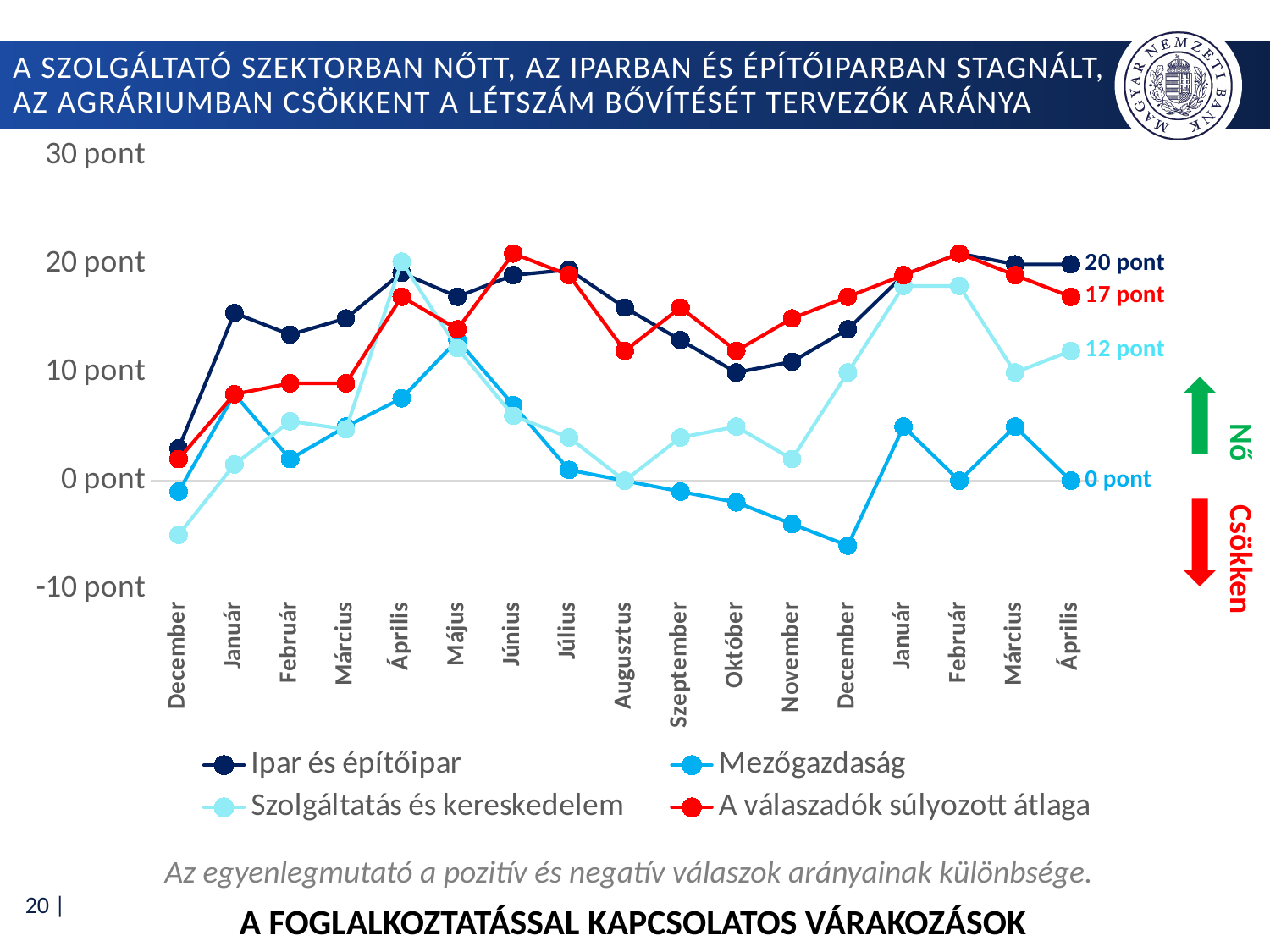
What is the value for Mezőgazdaság at the final Április? 0 pont What is the value for Szolgáltatás és kereskedelem at the final Április? 12 pont What kind of chart is shown on the slide? line chart What is the value for A válaszadók súlyozott átlaga at the final Április? 17 pont Is the value for Mezőgazdaság at the second December greater or less than 0 pont? less How many months are shown along the x axis? 17 What is the title printed below the chart? A FOGLALKOZTATÁSSAL KAPCSOLATOS VÁRAKOZÁSOK How many series does the legend list? 4 What is the value for Ipar és építőipar at the final Április? 20 pont Which series has the highest value at the final Április? Ipar és építőipar At the final Április, what is the difference between Ipar és építőipar and Szolgáltatás és kereskedelem? 8 pont At the final Április, which is larger: Ipar és építőipar or Mezőgazdaság? Ipar és építőipar